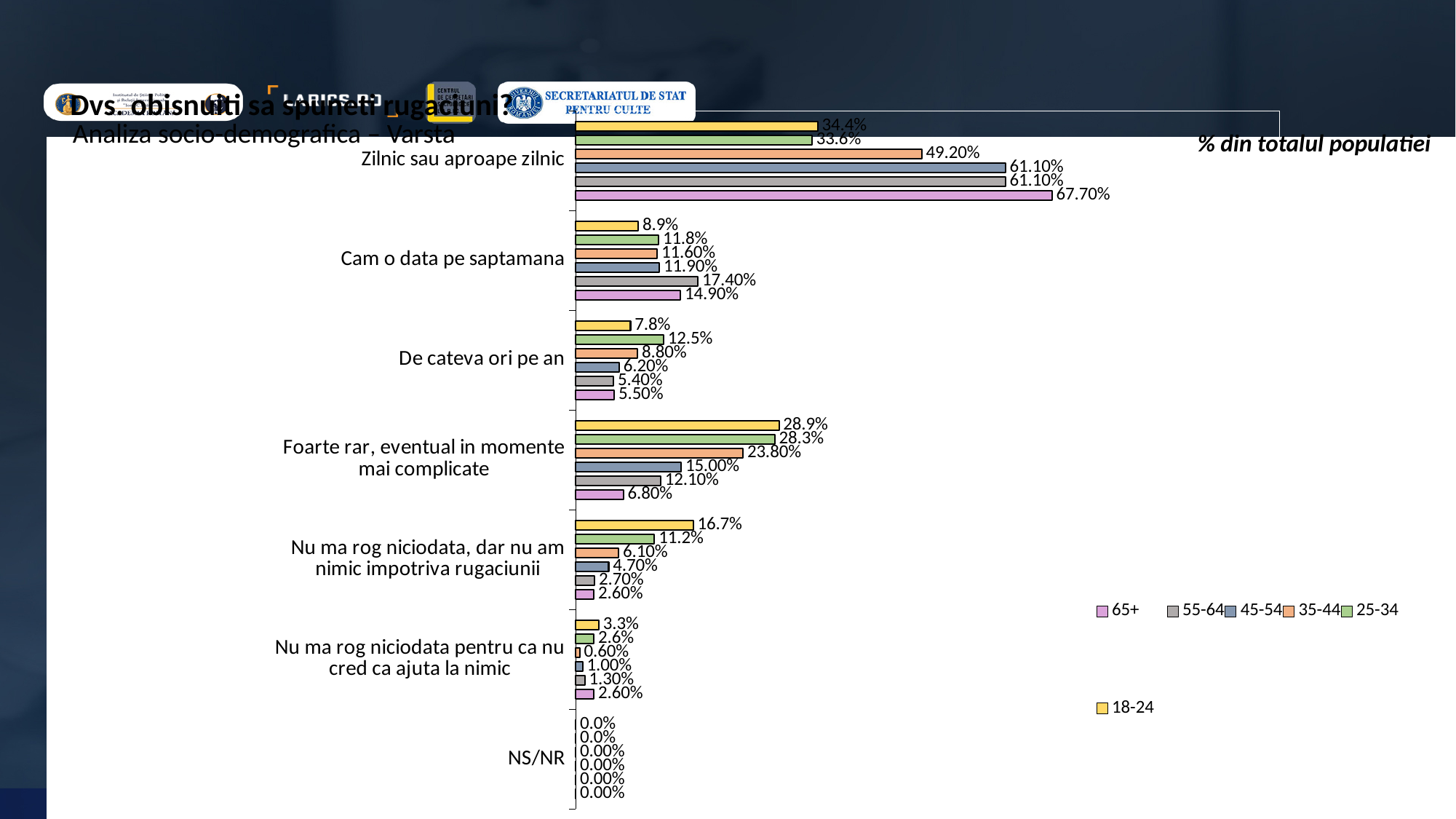
For 'De cateva ori pe an', which is larger: the value for 25-34 or the value for 35-44? 25-34 What is the value for the 18-24 age group for 'Foarte rar, eventual in momente mai complicate'? 28.9% How many age-group series does the legend list? 6 What is the value for the 55-64 age group for 'Cam o data pe saptamana'? 17.40% What kind of chart is shown on the slide? Bar chart What is the value for the 35-44 age group for 'Nu ma rog niciodata pentru ca nu cred ca ajuta la nimic'? 0.60% How many response categories are shown on the chart? 7 Which age group has the highest value for 'Zilnic sau aproape zilnic'? 65+ Which age group has the lowest value for 'Nu ma rog niciodata, dar nu am nimic impotriva rugaciunii'? 65+ What is the difference between the 18-24 and 65+ values for 'Foarte rar, eventual in momente mai complicate'? 22.1% What is the value for the 65+ age group for 'Zilnic sau aproape zilnic'? 67.70% Which colour represents the 18-24 age group in the legend? Yellow